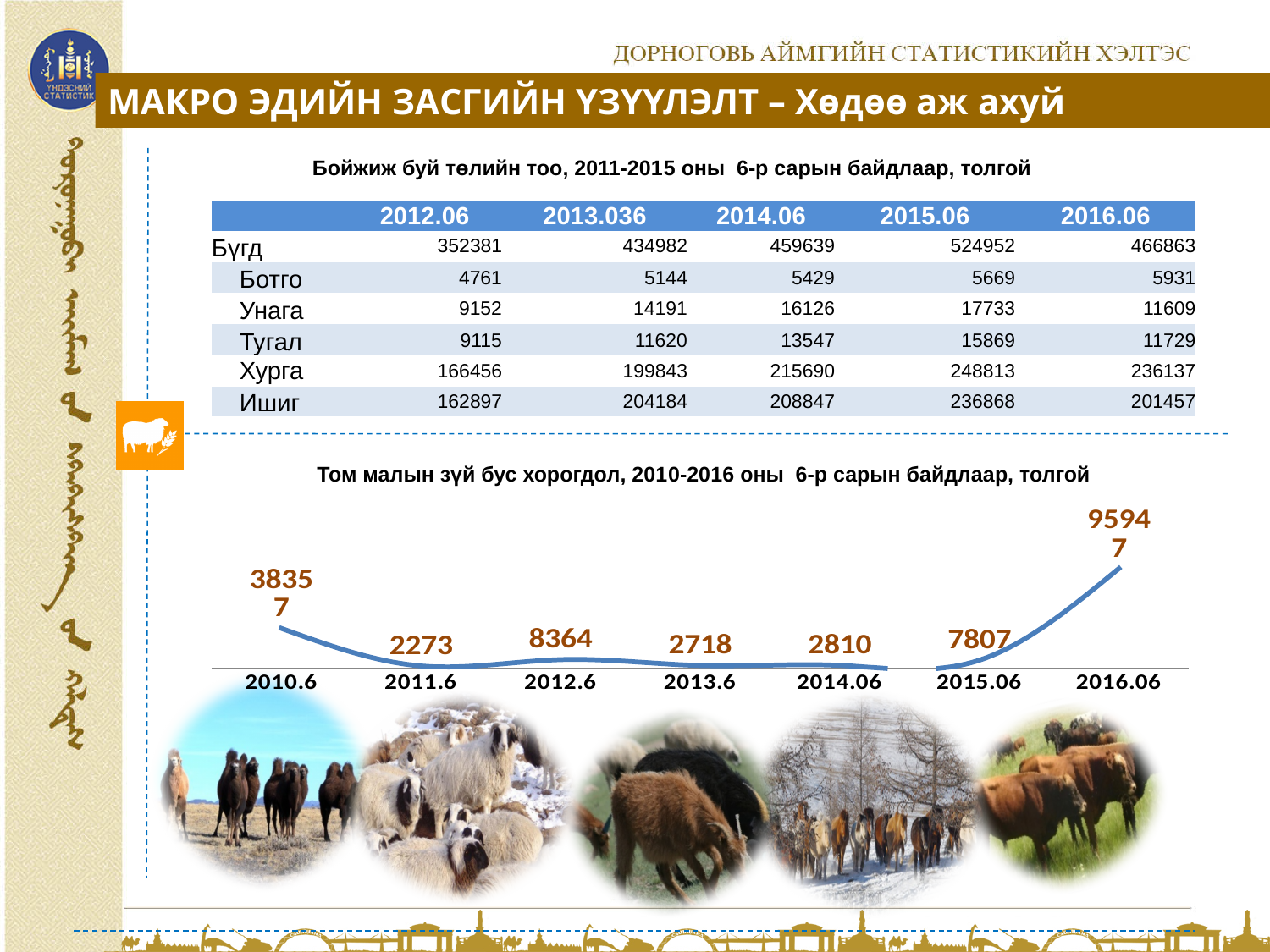
In the line chart, what is the value for 2016.06? 95947 In the line chart, does the value rise or fall from 2015.06 to 2016.06? Rise In the line chart, how many data points are plotted? 7 In the line chart, what is the value for 2015.06? 7807 In the line chart, which year has the lowest value? 2011.6 In the line chart, what is the value for 2012.6? 8364 In the line chart, which is larger: the value for 2012.6 or the value for 2015.06? 2012.6 In the line chart, which year has the highest value? 2016.06 What type of chart is shown under the title "Том малын зүй бус хорогдол, 2010-2016 оны 6-р сарын байдлаар, толгой"? Line chart In the line chart, what is the difference between the values for 2014.06 and 2013.6? 92 In the line chart, what is the difference between the values for 2016.06 and 2010.6? 57590 In the line chart, what is the value for 2011.6? 2273